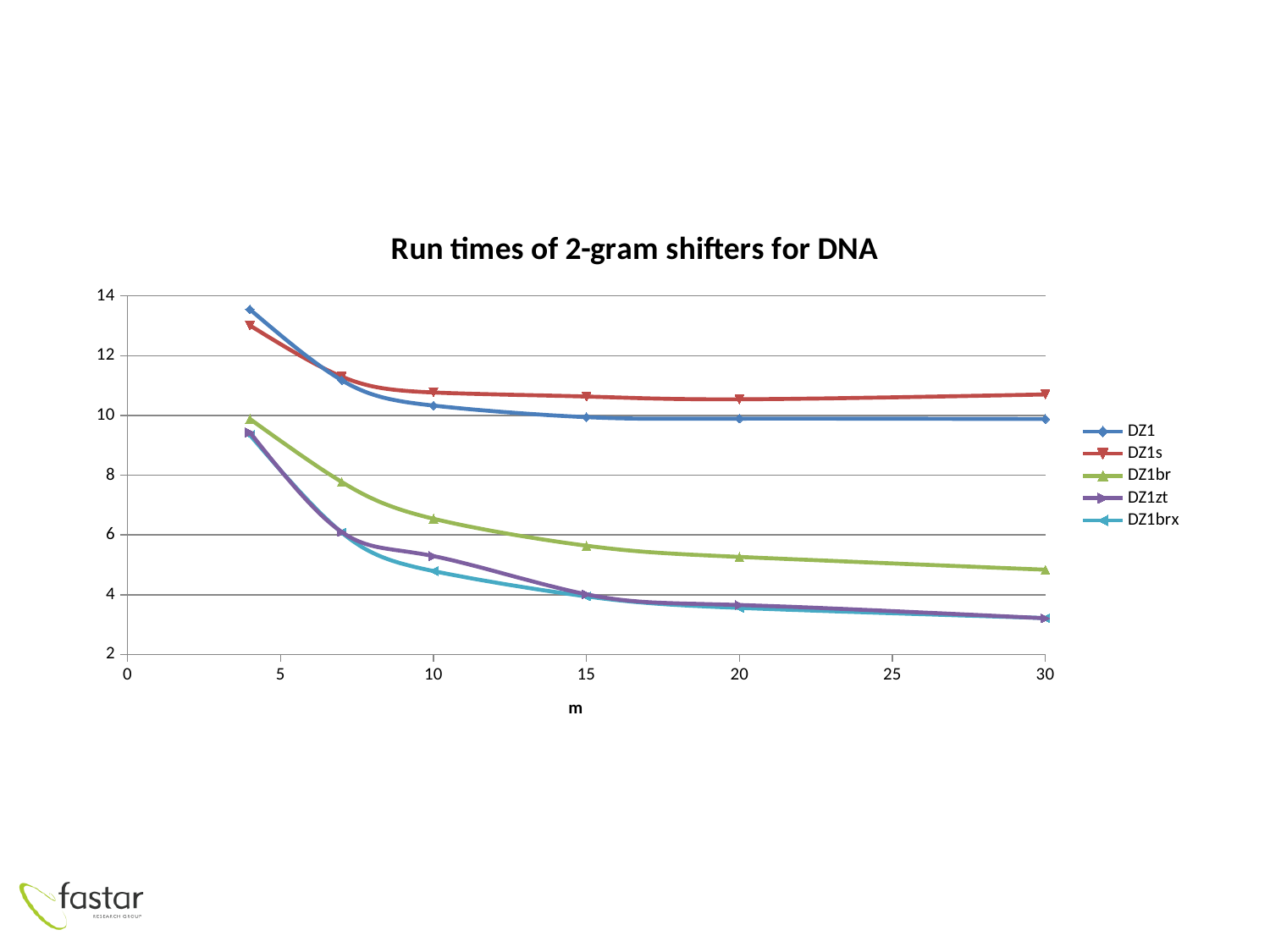
Is the value for DZ1br at m = 30 greater or less than 6? less Do the values for DZ1br rise or fall as m increases? fall Which series has the highest value at m = 30? DZ1s How many series does the legend list? 5 At m = 20, which is larger, DZ1br or DZ1zt? DZ1br What is the label of the x axis? m What is the title of the chart? Run times of 2-gram shifters for DNA What kind of chart is shown on the slide? line chart Is the value for DZ1s at m = 30 greater or less than 10? greater Is the value for DZ1 at m = 4 greater or less than 12? greater How many data points are plotted for the DZ1 series? 6